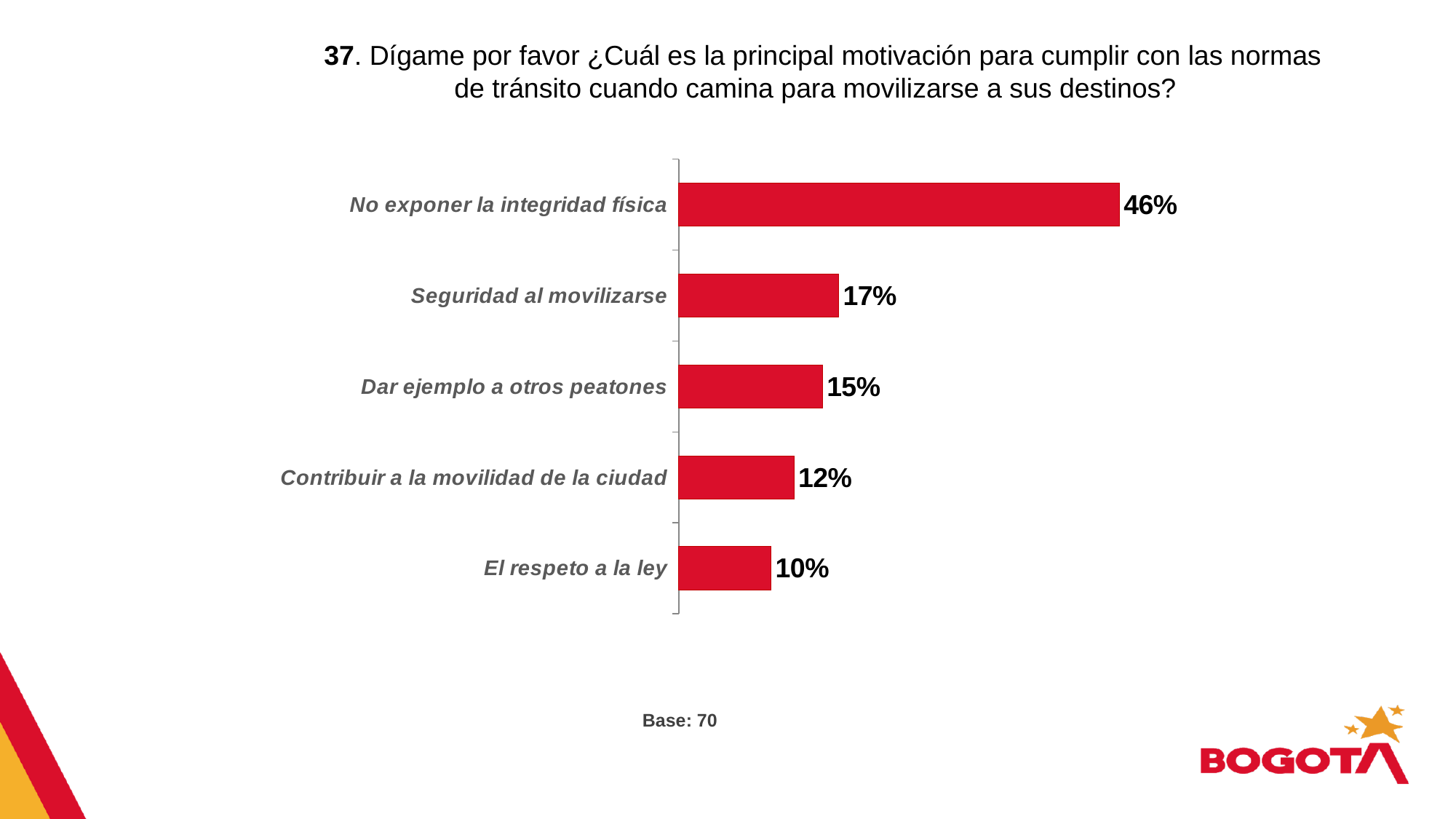
How many categories are shown in the chart? 5 What is the difference between "No exponer la integridad física" and "Seguridad al movilizarse"? 29% What is the value for "No exponer la integridad física"? 46% What kind of chart is shown on the slide? Bar chart What is the value for "Contribuir a la movilidad de la ciudad"? 12% What is the value for "Dar ejemplo a otros peatones"? 15% Which category has the highest value? No exponer la integridad física Which is larger, "Seguridad al movilizarse" or "Contribuir a la movilidad de la ciudad"? Seguridad al movilizarse What is the value for "Seguridad al movilizarse"? 17% Which category has the lowest value? El respeto a la ley What is the value for "El respeto a la ley"? 10% What is the difference between "Dar ejemplo a otros peatones" and "El respeto a la ley"? 5%